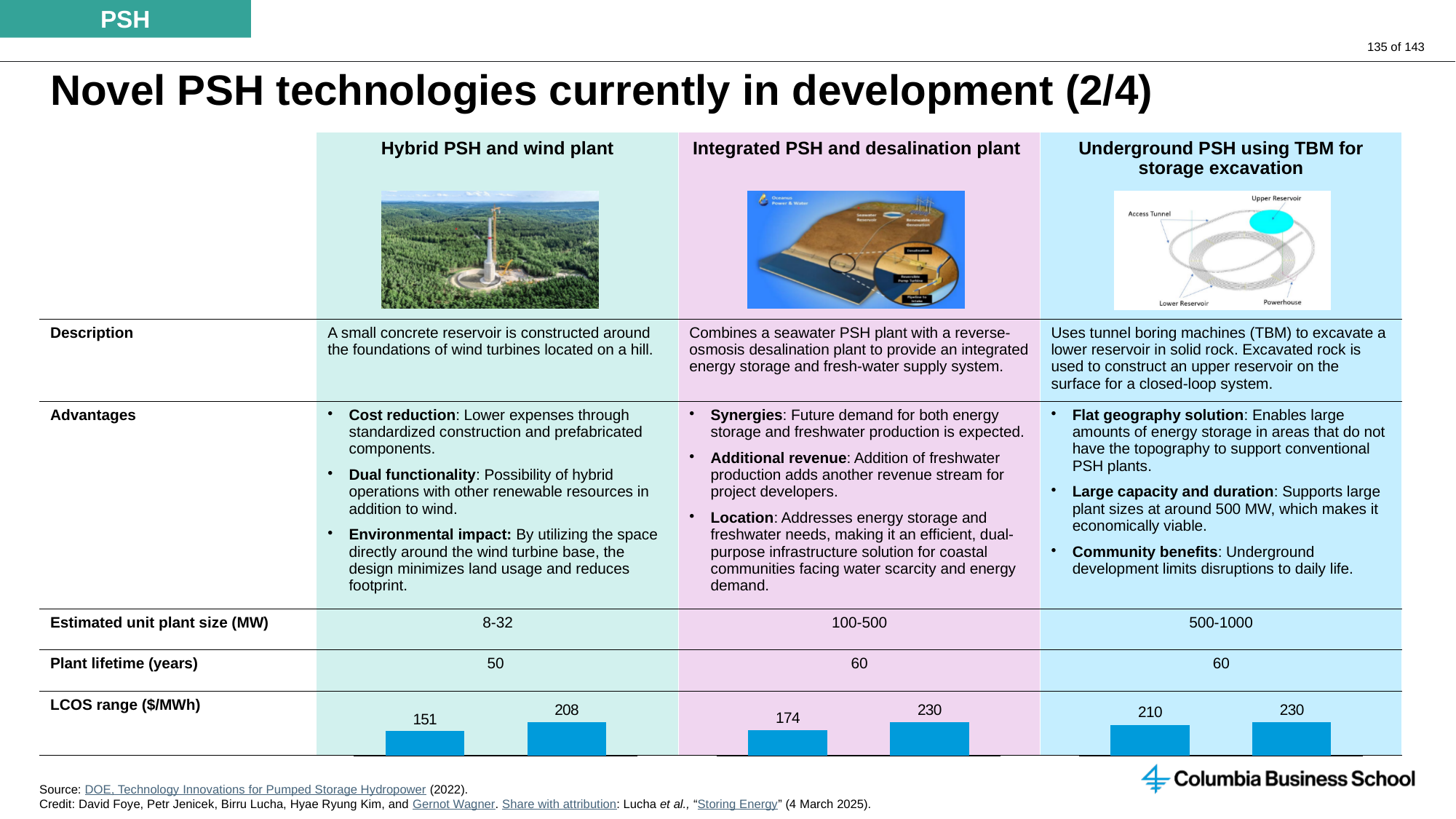
In the LCOS range chart for the Underground PSH using TBM for storage excavation, what is the difference between the two bars? 20 In the LCOS range chart for the Hybrid PSH and wind plant, what is the value of the left bar? 151 In the LCOS range chart for the Integrated PSH and desalination plant, what is the difference between the two bars? 56 In the LCOS range chart for the Underground PSH using TBM for storage excavation, what is the value of the left bar? 210 How many bars are shown in the LCOS range chart for the Integrated PSH and desalination plant? 2 In the LCOS range chart for the Hybrid PSH and wind plant, what is the value of the right bar? 208 In the LCOS range chart for the Hybrid PSH and wind plant, what is the difference between the right bar and the left bar? 57 In the LCOS range chart for the Hybrid PSH and wind plant, which bar is larger, the left or the right? right In the LCOS range chart for the Integrated PSH and desalination plant, what is the value of the left bar? 174 What kind of chart is used to show the LCOS range for each technology? bar chart In the LCOS range chart for the Underground PSH using TBM for storage excavation, what is the value of the right bar? 230 In the LCOS range chart for the Integrated PSH and desalination plant, what is the value of the right bar? 230